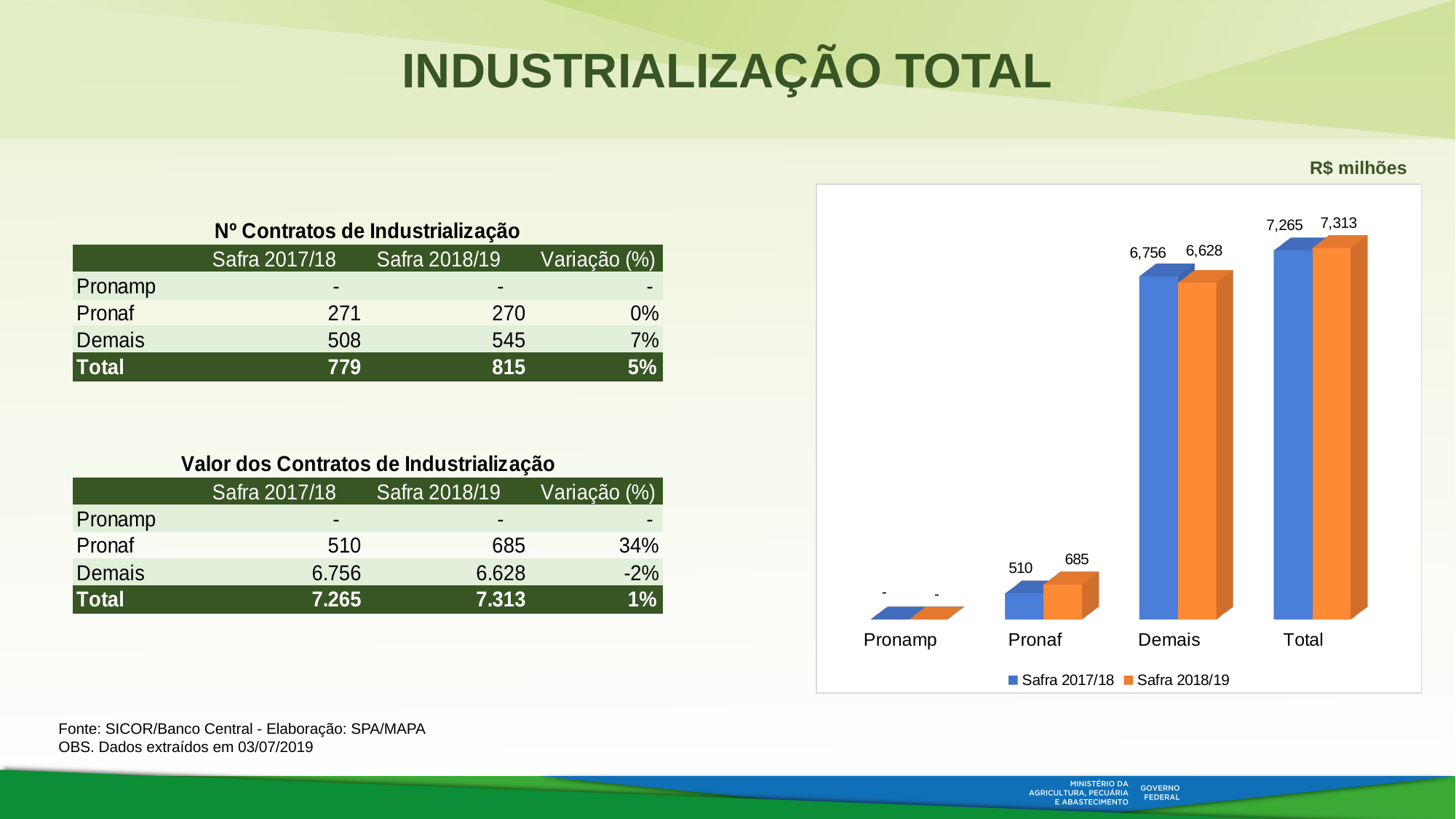
How many series does the chart legend list? 2 What is the value for Pronaf in the Safra 2018/19 series? 685 How many categories are shown on the x axis of the chart? 4 What is the difference between the Safra 2018/19 and Safra 2017/18 values for Pronaf? 175 What unit is indicated above the chart? R$ milhões What is the value for Total in the Safra 2018/19 series? 7,313 Which category has the highest value in the Safra 2017/18 series? Total What kind of chart is shown on the slide? bar chart What is the value for Pronaf in the Safra 2017/18 series? 510 What is the value for Demais in the Safra 2017/18 series? 6,756 For Demais, which series has the larger value, Safra 2017/18 or Safra 2018/19? Safra 2017/18 What are the two series named in the chart legend? Safra 2017/18 and Safra 2018/19